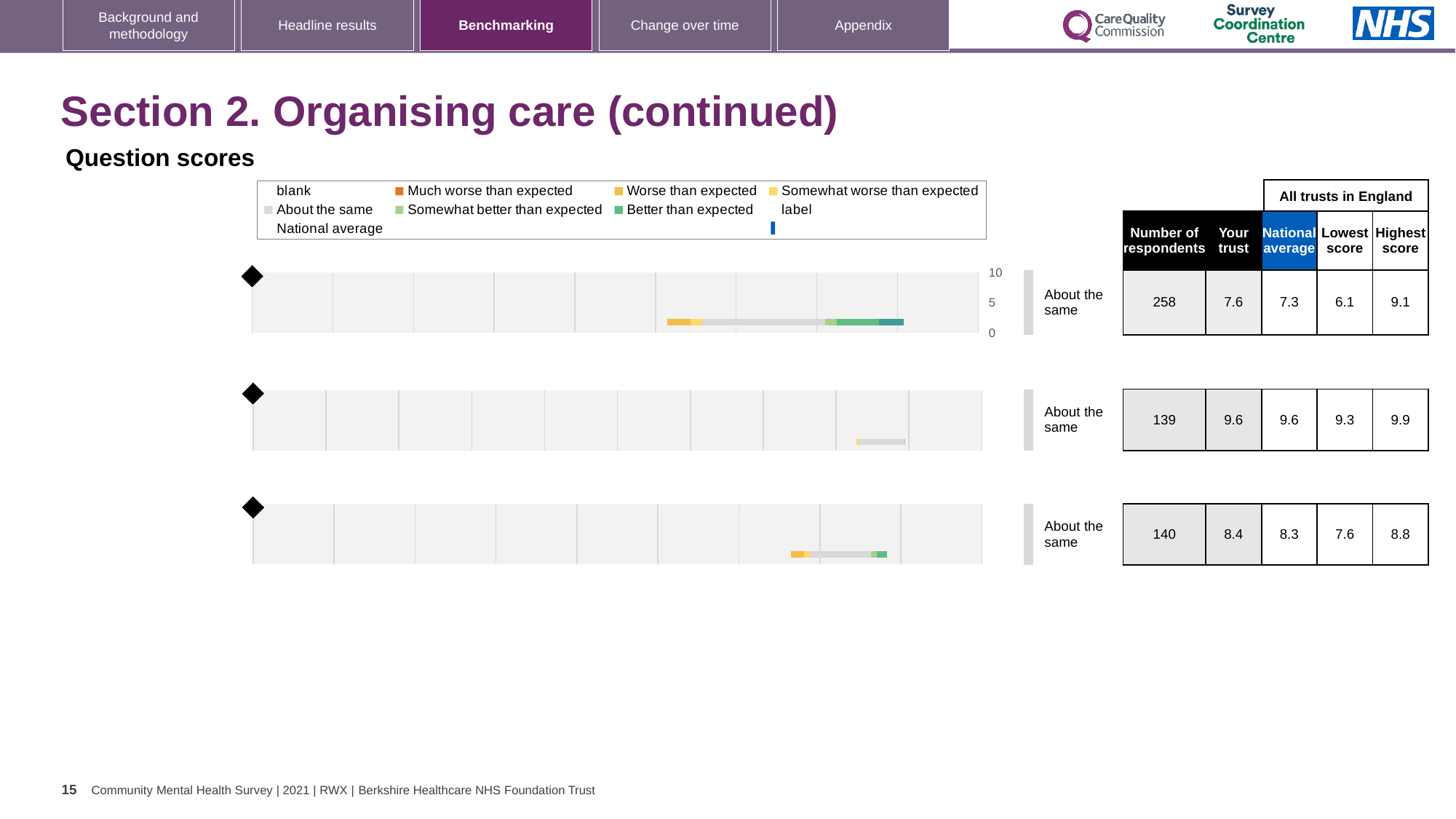
For the top chart, what is the "Your trust" score shown in the table row beside it? 7.6 How many benchmarking charts are shown on the slide? 3 What is the highest tick value shown on the vertical axis of the top chart? 10 For the middle chart, what is the "National average" score shown in the table row beside it? 9.6 For the top chart, which is larger: the "Your trust" score or the "National average" score? Your trust What colour does the legend use for "Much worse than expected"? orange For the bottom chart, what is the "Number of respondents" shown in the table row beside it? 140 What benchmark category label is printed beside each of the three charts? About the same For the bottom chart, what is the "Lowest score" shown in the table row beside it? 7.6 Which chart (top, middle or bottom) has the highest "Your trust" score in its table row? middle For the top chart, what is the difference between the "Highest score" and the "Lowest score" in the table row beside it? 3.0 What kind of chart is used for the three benchmarking charts on the slide? bar chart